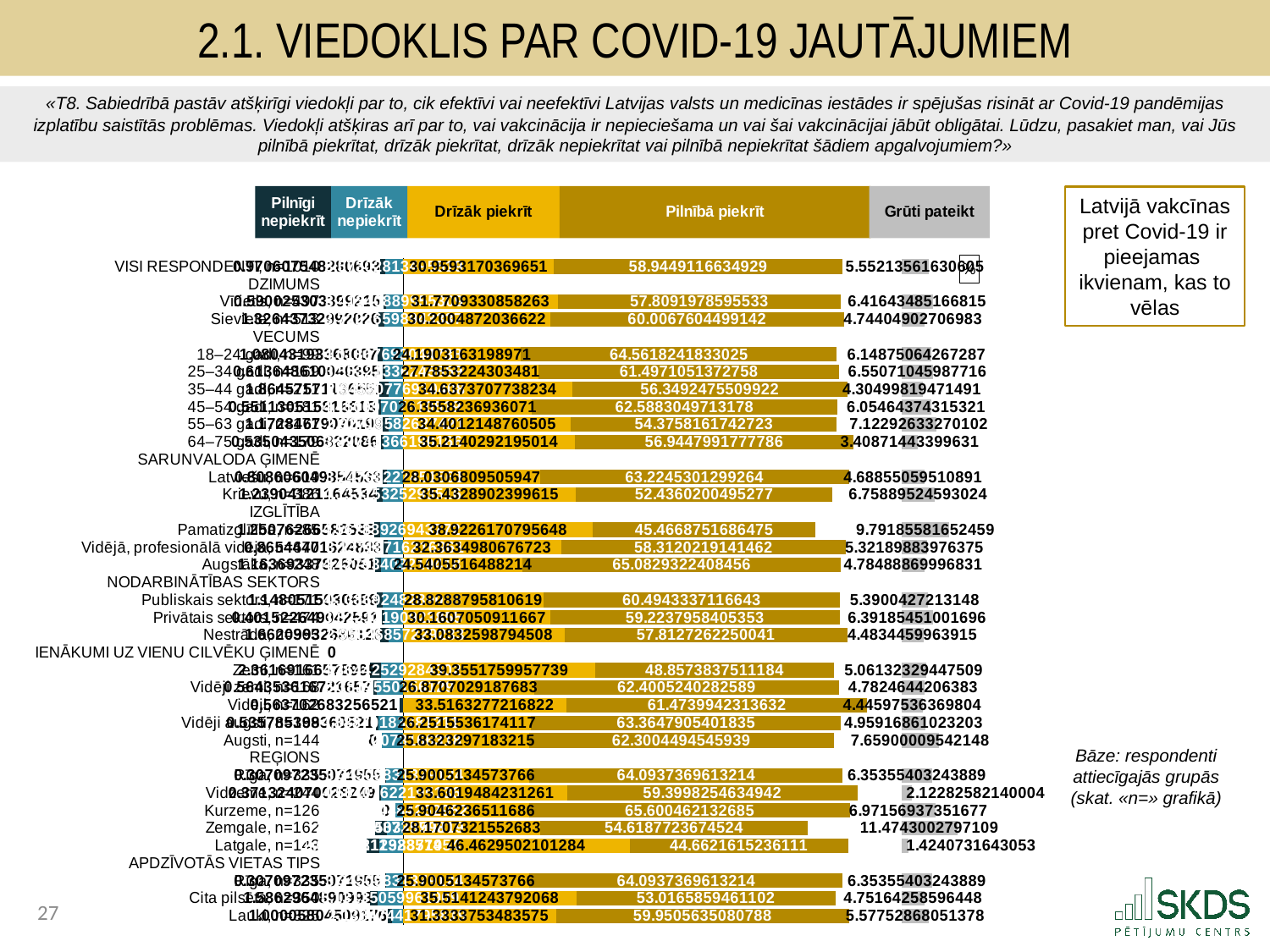
Among the regions (Rīga, Vidzeme, Kurzeme, Zemgale, Latgale), which has the highest 'Pilnībā piekrīt' value? Kurzeme, n=126 What is the 'Pilnībā piekrīt' value for Pamatizglītība? 45.4668751686475 Which statement is the chart about, as shown in the box to the right of the chart? Latvijā vakcīnas pret Covid-19 ir pieejamas ikvienam, kas to vēlas What is the 'Drīzāk piekrīt' value for Latgale, n=143? 46.4629502101284 Which has the larger 'Pilnībā piekrīt' value: Latviešu or Krievu (Sarunvaloda ģimenē)? Latviešu How many series does the legend of the chart list? 5 Which legend entry is shown in the dark gold colour used for the longest bar segments? Pilnībā piekrīt What kind of chart is shown on the slide? bar chart What is the 'Pilnībā piekrīt' value for Kurzeme, n=126? 65.600462132685 What is the 'Grūti pateikt' value for Zemgale, n=162? 11.4743002797109 Among the regions (Rīga, Vidzeme, Kurzeme, Zemgale, Latgale), which has the lowest 'Pilnībā piekrīt' value? Latgale, n=143 What is the difference between the 'Pilnībā piekrīt' values for Augstākā and Pamatizglītība? 19.6160570721981